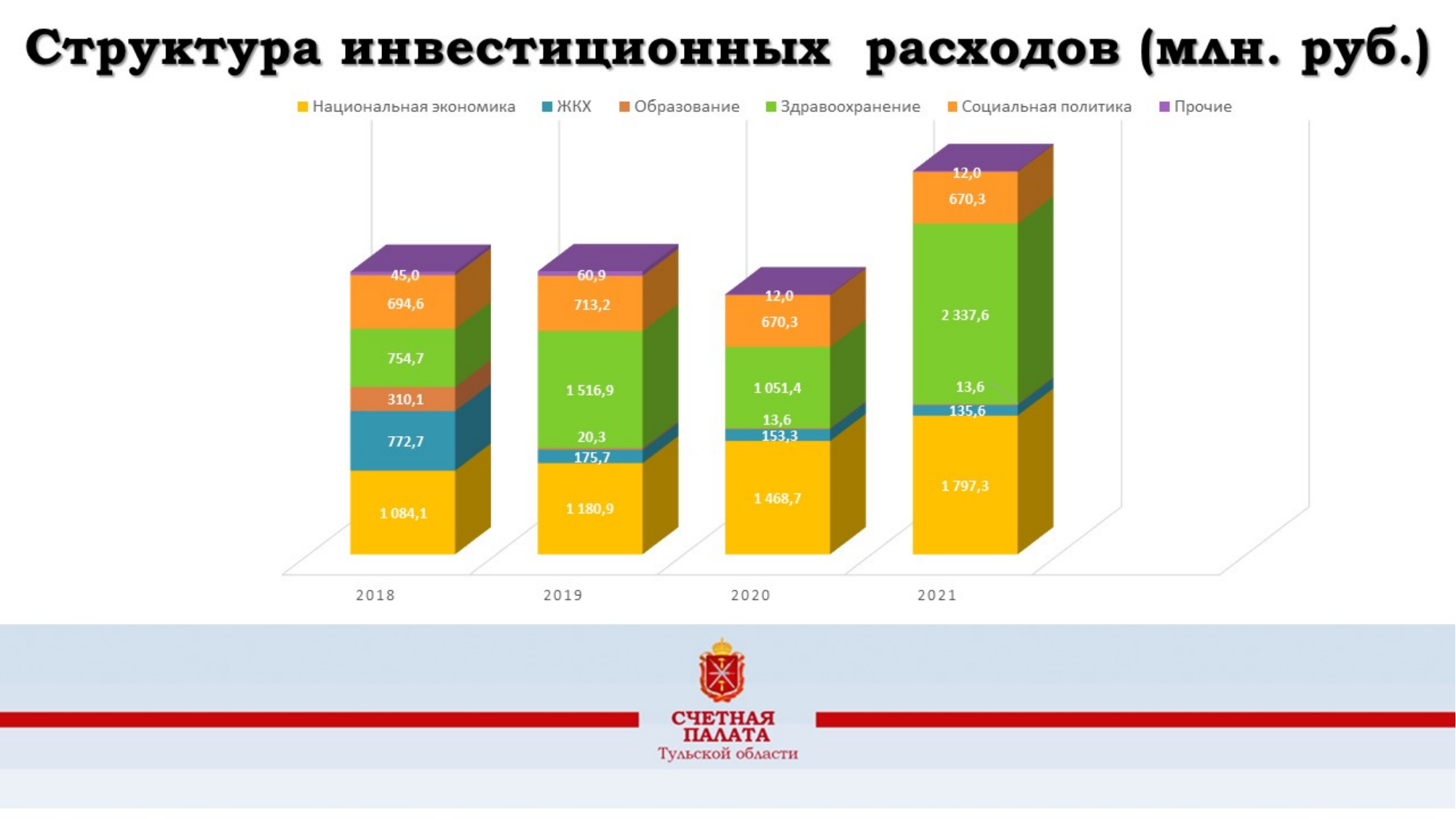
What is the value for Социальная политика in 2019? 713,2 By how much does Здравоохранение in 2021 exceed Здравоохранение in 2020? 1 286,2 What is the value for Национальная экономика in 2021? 1 797,3 In which year is the value for Здравоохранение the lowest? 2018 In which year is the value for Национальная экономика the highest? 2021 What is the value for ЖКХ in 2018? 772,7 Which year has the larger value for ЖКХ, 2018 or 2019? 2018 How many series does the legend list? 6 What is the total of the stacked bar for 2018? 3 661,2 What is the value for Здравоохранение in 2019? 1 516,9 How many years are shown on the x axis? 4 What kind of chart is shown on the slide? Stacked bar chart